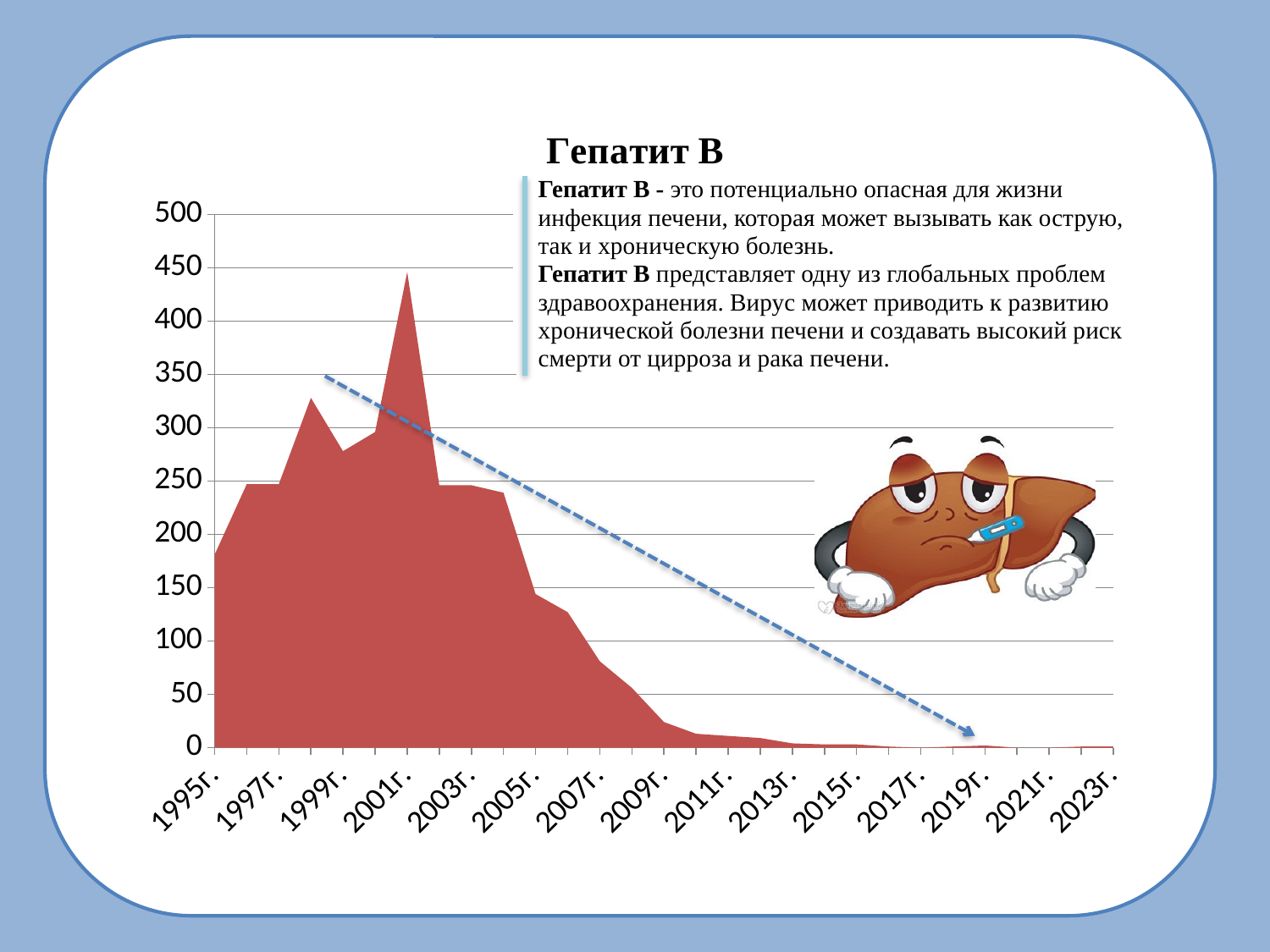
What does the dashed blue arrow drawn over the chart indicate? a downward trend Overall, do the values rise or fall from 2001г. to 2023г.? fall What kind of chart is shown on the slide? area chart Is the value for 1999г. greater or less than 250? greater Is the value for 2009г. greater or less than 50? less Which year has the larger value, 2001г. or 2009г.? 2001г. Is the value for 1995г. greater or less than 150? greater In which year does the chart reach its highest value? 2001г.